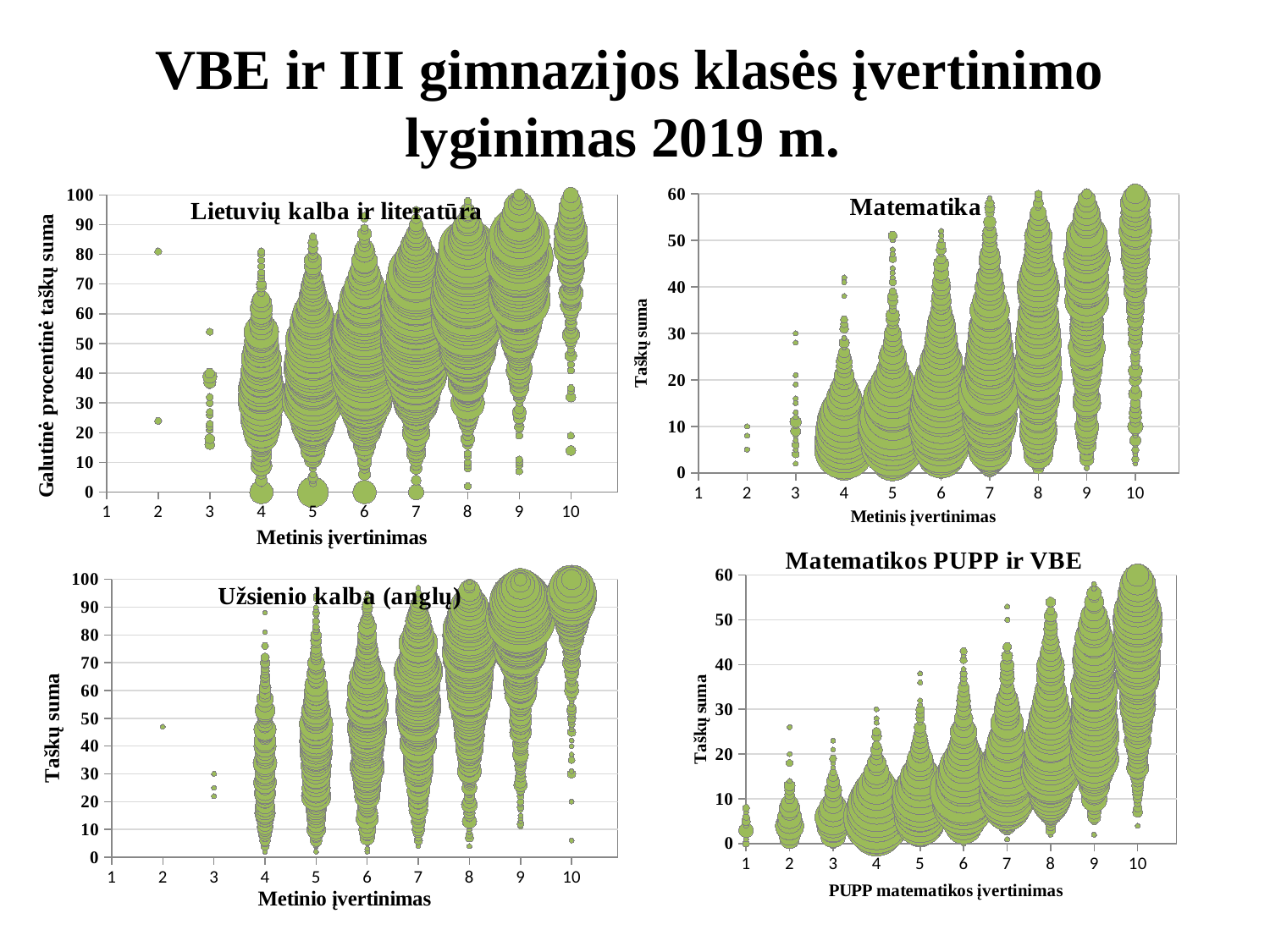
How many grade values are shown on the x axis of the 'Matematika' chart? 10 In the 'Matematikos PUPP ir VBE' chart, is the highest point at PUPP grade 1 greater or less than 20? less In the 'Matematikos PUPP ir VBE' chart, do the point scores generally rise or fall as the PUPP grade increases? rise What is the x-axis title of the 'Matematikos PUPP ir VBE' chart? PUPP matematikos įvertinimas In the 'Užsienio kalba (anglų)' chart, is the point at annual grade 2 greater or less than 40? greater In the 'Matematika' chart, do the point scores generally rise or fall as the annual grade (Metinis įvertinimas) increases? rise What is the title of the top-left chart? Lietuvių kalba ir literatūra What kind of chart is the 'Matematika' chart? bubble chart In the 'Matematika' chart, are the points at annual grade 2 greater or less than 20? less What kind of chart is the 'Užsienio kalba (anglų)' chart? bubble chart